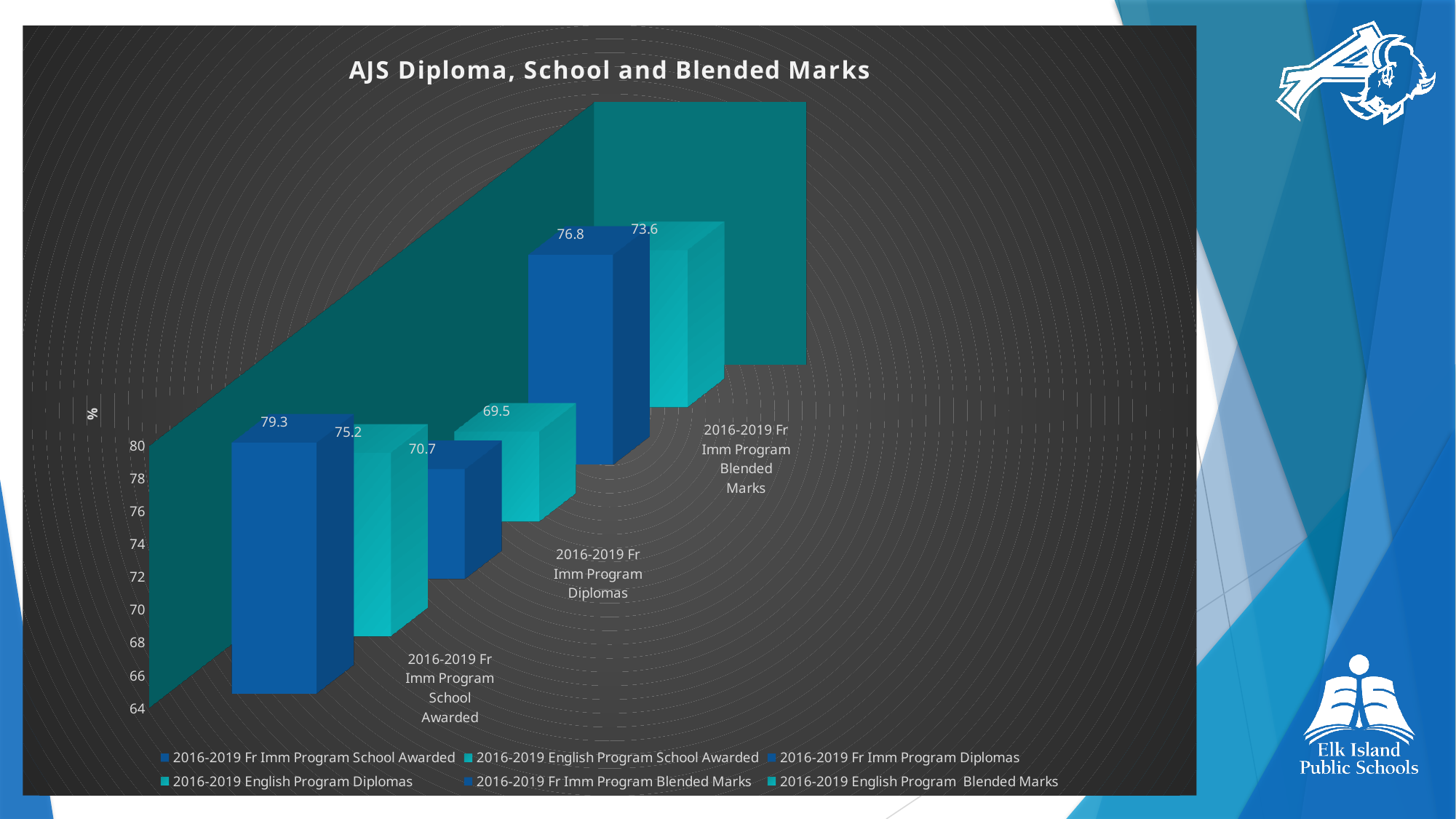
Which bar has the highest value on the chart? 2016-2019 Fr Imm Program School Awarded What type of chart is shown on the slide? bar chart What is the value of the 2016-2019 English Program School Awarded bar? 75.2 What is the difference between the 2016-2019 Fr Imm Program School Awarded value and the 2016-2019 English Program School Awarded value? 4.1 Which is larger, the 2016-2019 Fr Imm Program Blended Marks value or the 2016-2019 English Program Blended Marks value? 2016-2019 Fr Imm Program Blended Marks What is the value of the 2016-2019 English Program Blended Marks bar? 73.6 What is the value of the 2016-2019 English Program Diplomas bar? 69.5 What is the value of the 2016-2019 Fr Imm Program School Awarded bar? 79.3 How many series does the chart legend list? 6 What is the title of the chart? AJS Diploma, School and Blended Marks What is the value of the 2016-2019 Fr Imm Program Diplomas bar? 70.7 What is the value of the 2016-2019 Fr Imm Program Blended Marks bar? 76.8